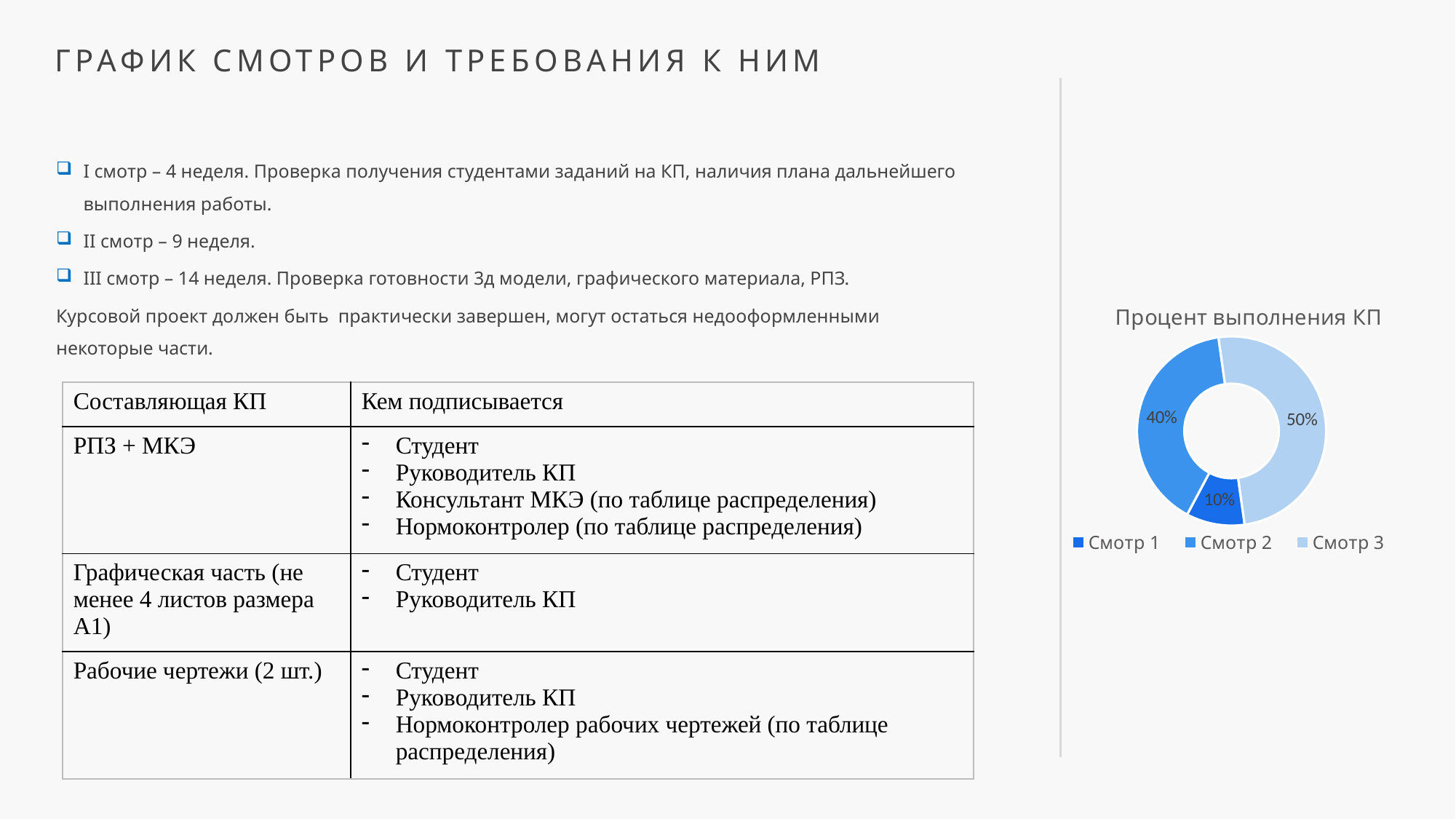
Which category has the largest slice in the chart? Смотр 3 Which is larger, the value for Смотр 2 or the value for Смотр 1? Смотр 2 Which category has the smallest slice in the chart? Смотр 1 What share of the doughnut does Смотр 3 represent? 50% What kind of chart is shown on the slide? Doughnut chart What is the title of the chart on the slide? Процент выполнения КП What is the difference between the values for Смотр 3 and Смотр 2? 10% What is the value for Смотр 1 in the chart? 10% How many slices does the doughnut chart have? 3 What is the value for Смотр 3 in the chart? 50% How many entries does the chart legend list? 3 What is the value for Смотр 2 in the chart? 40%